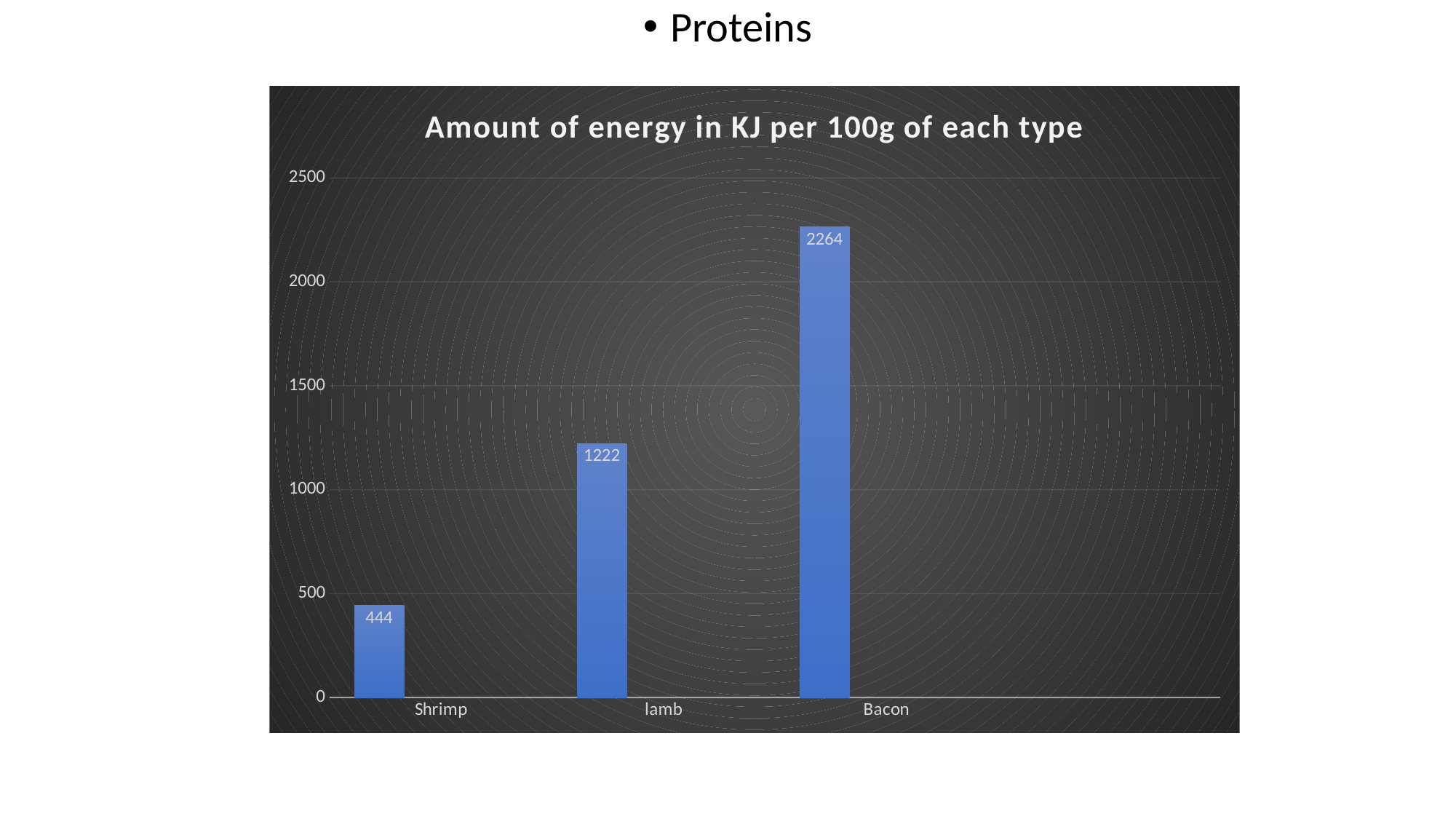
Which category has the lowest value? Shrimp Which is larger, the value for Shrimp or the value for lamb? lamb Is the value for Bacon greater or less than 2000? greater What is the title of the chart? Amount of energy in KJ per 100g of each type What is the difference between the values for lamb and Shrimp? 778 What is the difference between the values for Bacon and lamb? 1042 What is the value for Bacon? 2264 What is the value for Shrimp? 444 How many categories are shown on the x axis? 3 What is the value for lamb? 1222 What kind of chart is shown on the slide? bar chart Which category has the highest value? Bacon